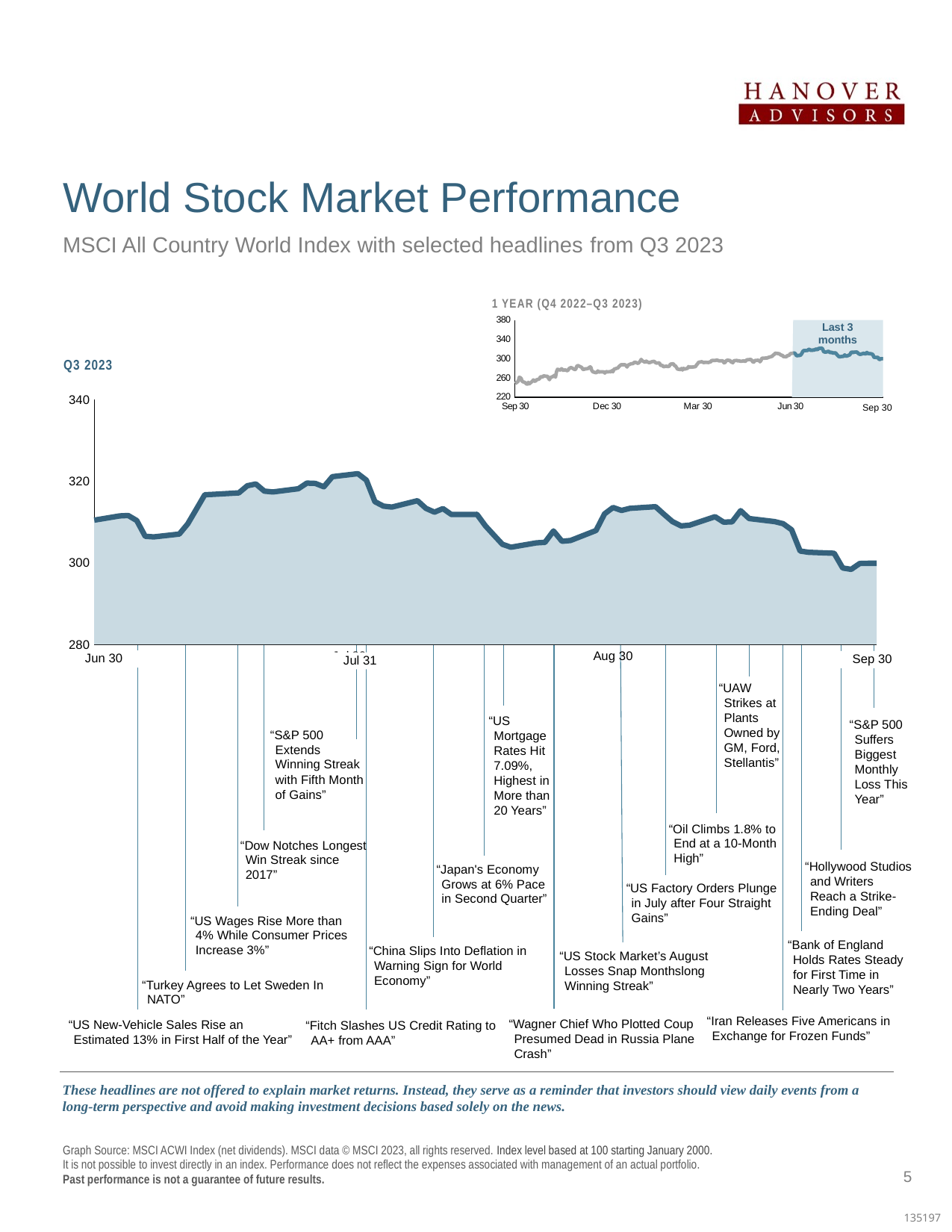
On the Q3 2023 chart, is the highest point of the line (in late July) greater or less than 320? greater On the Q3 2023 chart, which is higher: the index value at Jun 30 or at Sep 30? Jun 30 On the Q3 2023 chart, does the index end the quarter (Sep 30) higher or lower than it started (Jun 30)? lower What is the highest value shown on the y axis of the Q3 2023 chart? 340 What kind of chart is the Q3 2023 chart on the slide? area chart How many date labels are shown on the x axis of the Q3 2023 chart? 4 On the Q3 2023 chart, is the index value at Aug 30 greater or less than 300? greater On the 1 YEAR (Q4 2022–Q3 2023) inset chart, is the index value at Dec 30 greater or less than 300? less What is the label of the shaded region on the 1 YEAR (Q4 2022–Q3 2023) inset chart? Last 3 months On the 1 YEAR (Q4 2022–Q3 2023) inset chart, does the index rise or fall overall from the start to the end of the period? rise